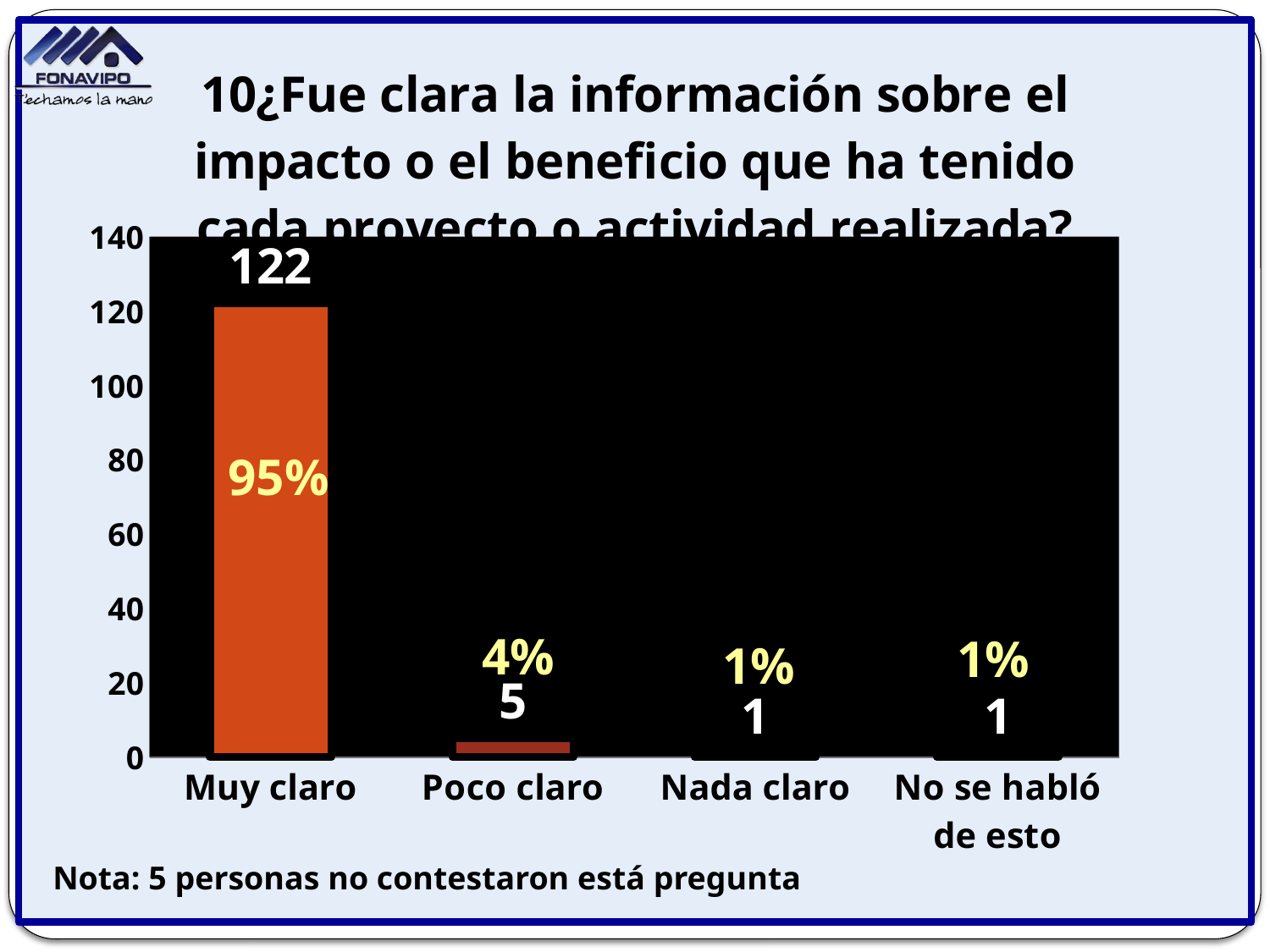
What is the difference between the values for Muy claro and Poco claro? 117 What kind of chart is shown on the slide? bar chart What is the value for Poco claro? 5 What is the value for Muy claro? 122 Which category has the highest value? Muy claro How many categories are shown on the x axis? 4 Which is larger, the value for Poco claro or the value for Nada claro? Poco claro What percentage is shown for Poco claro? 4% What percentage is shown for Muy claro? 95% Is the value for Muy claro greater or less than 100? greater According to the note on the slide, how many people did not answer this question? 5 What is the value for Nada claro? 1